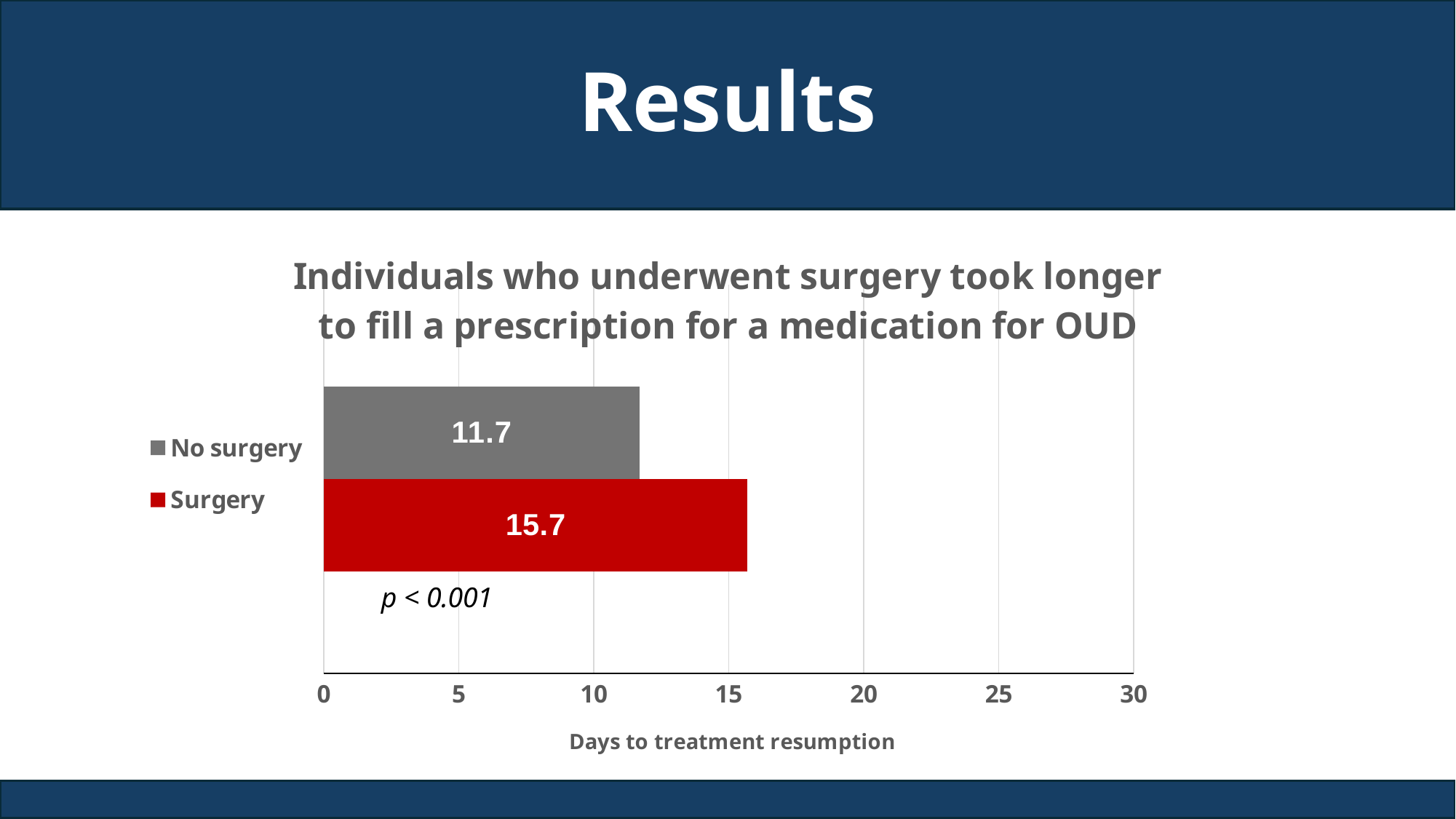
Is the value for Surgery greater or less than 15? greater What is the value for Surgery? 15.7 Which group has the higher number of days to treatment resumption? Surgery Which is larger, the value for Surgery or the value for No surgery? Surgery Which group has the lower number of days to treatment resumption? No surgery What kind of chart is shown on the slide? Bar chart What colour is the Surgery bar? Red What is the difference between the Surgery and No surgery values? 4 Is the value for No surgery greater or less than 10? greater How many series does the legend list? 2 What is the label of the horizontal axis? Days to treatment resumption What is the value for No surgery? 11.7